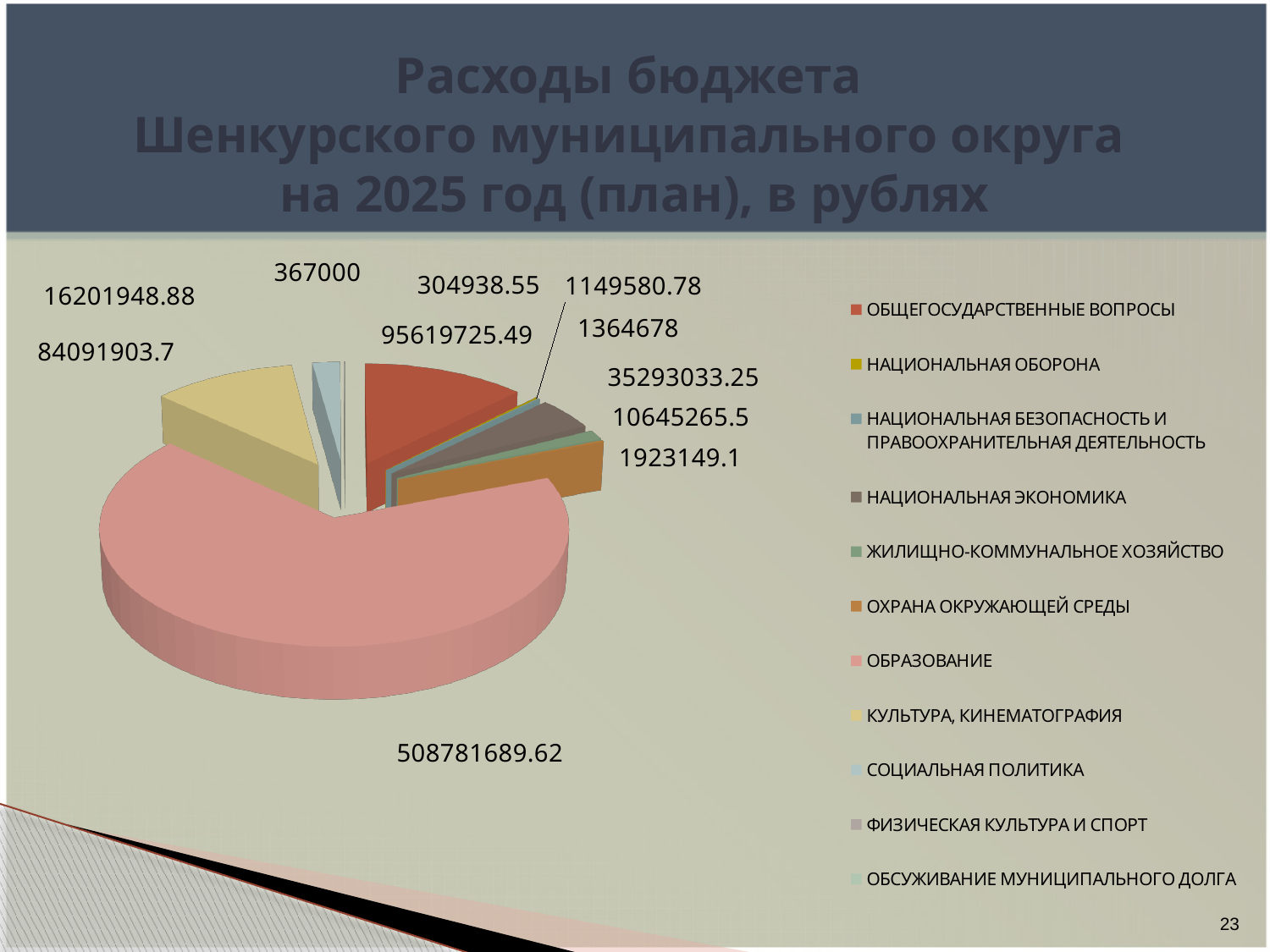
What is the value shown for ОБЩЕГОСУДАРСТВЕННЫЕ ВОПРОСЫ? 95619725.49 What is the value shown for КУЛЬТУРА, КИНЕМАТОГРАФИЯ? 84091903.7 What is the value shown for ОБРАЗОВАНИЕ? 508781689.62 What is the smallest data label value shown on the pie chart? 304938.55 What type of chart is shown on the slide? pie chart What is the value shown for СОЦИАЛЬНАЯ ПОЛИТИКА? 16201948.88 Which is larger, the value for ОБРАЗОВАНИЕ or the value for КУЛЬТУРА, КИНЕМАТОГРАФИЯ? ОБРАЗОВАНИЕ How many categories does the legend of the pie chart list? 11 Which is larger, the value for ОБЩЕГОСУДАРСТВЕННЫЕ ВОПРОСЫ or the value for КУЛЬТУРА, КИНЕМАТОГРАФИЯ? ОБЩЕГОСУДАРСТВЕННЫЕ ВОПРОСЫ What is the title of the slide containing the chart? Расходы бюджета Шенкурского муниципального округа на 2025 год (план), в рублях What is the difference between the value for ОБРАЗОВАНИЕ and the value for КУЛЬТУРА, КИНЕМАТОГРАФИЯ? 424689785.92 Which category has the largest slice of the pie? ОБРАЗОВАНИЕ